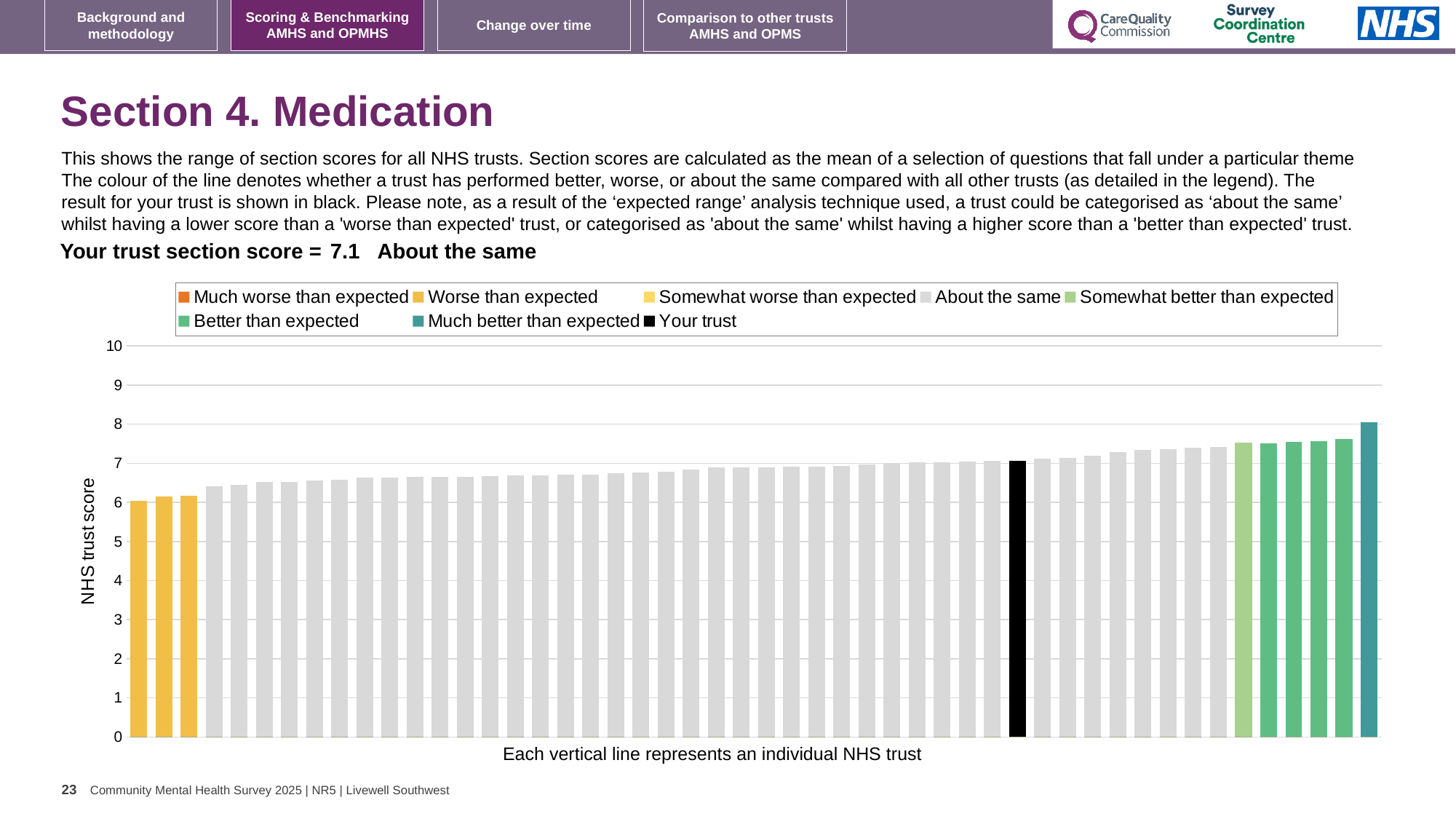
Is the value of the lowest bar greater or less than 7? less What kind of chart is shown on the slide? bar chart Which legend category does the lowest bar on the chart belong to? Worse than expected What is the label on the vertical axis of the chart? NHS trust score What is the section score for your trust shown on the slide? 7.1 How many entries does the chart legend list? 8 How many bars are coloured as 'Worse than expected'? 3 Is the value of the black 'Your trust' bar greater or less than 5? greater Which legend category does the highest bar on the chart belong to? Much better than expected Which category is your trust placed in for the Medication section? About the same How many bars are coloured as 'Better than expected'? 4 Do the bar values rise or fall from left to right along the x axis? rise